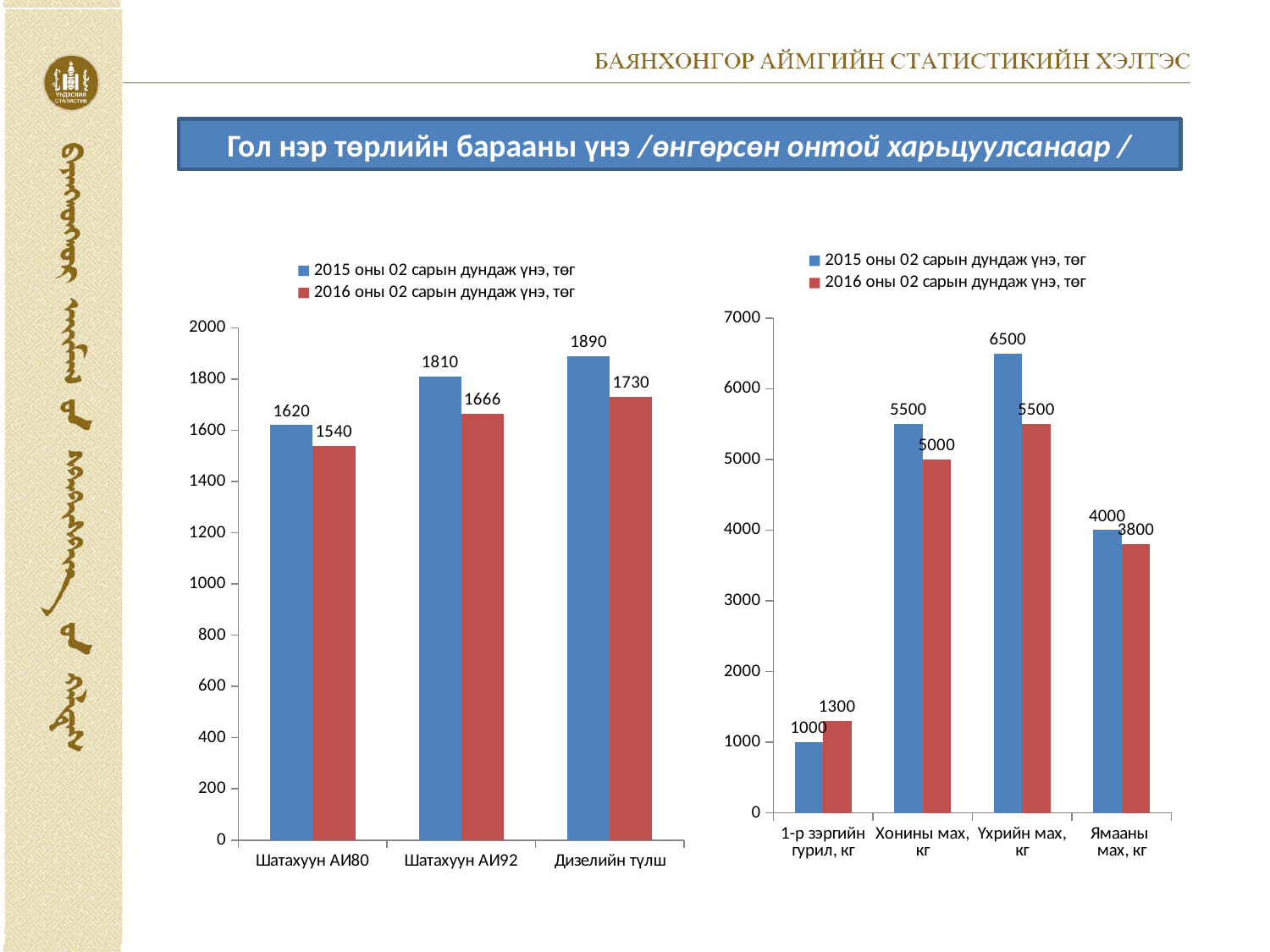
What type of chart is the left chart? Bar chart In the left chart, what is the 2016 оны 02 сарын дундаж үнэ for Шатахуун АИ92? 1666 In the left chart, which category has the highest 2015 value? Дизелийн түлш In the left chart, how many categories are shown on the x axis? 3 In the right chart, which category has the lowest 2015 value? 1-р зэргийн гурил, кг In the left chart, what is the 2015 оны 02 сарын дундаж үнэ for Шатахуун АИ80? 1620 In the left chart, what is the difference between the 2015 and 2016 values for Дизелийн түлш? 160 In the right chart, which is larger for 1-р зэргийн гурил, кг: the 2015 value or the 2016 value? 2016 value In the right chart, what is the 2015 оны 02 сарын дундаж үнэ for Үхрийн мах, кг? 6500 How many series does the legend of the right chart list? 2 In the right chart, what is the 2016 оны 02 сарын дундаж үнэ for Хонины мах, кг? 5000 In the right chart, what is the difference between the 2015 and 2016 values for Ямааны мах, кг? 200